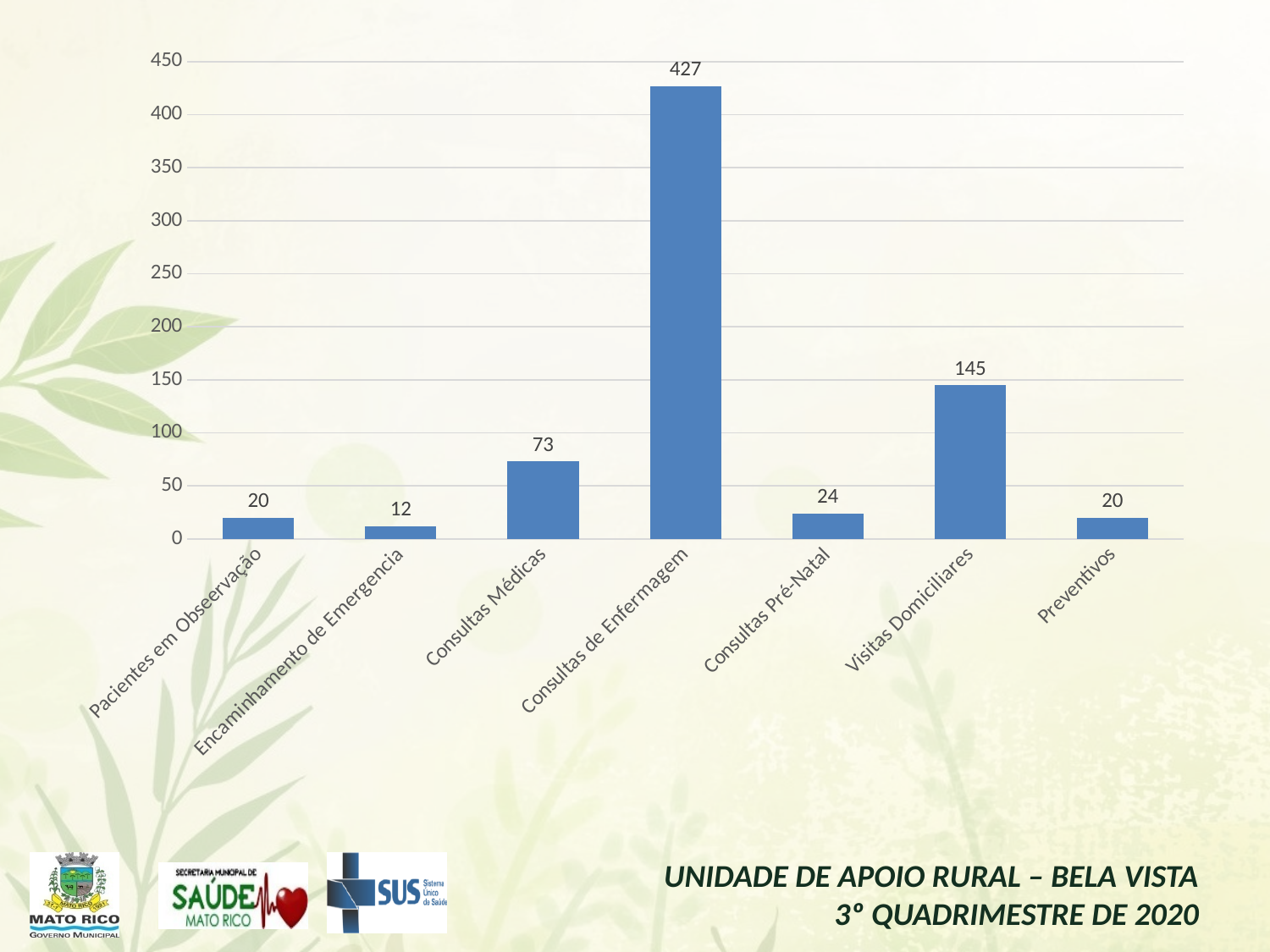
What is the value for Encaminhamento de Emergencia? 12 What is the value for Visitas Domiciliares? 145 What is the value for Consultas Médicas? 73 What is the highest value shown on the vertical axis? 450 Which is larger, Consultas Pré-Natal or Preventivos? Consultas Pré-Natal Which category has the lowest value? Encaminhamento de Emergencia How many categories are shown on the x axis? 7 What is the difference between Consultas de Enfermagem and Visitas Domiciliares? 282 What kind of chart is shown on the slide? Bar chart What is the difference between Consultas Médicas and Consultas Pré-Natal? 49 What is the value for Consultas de Enfermagem? 427 Which category has the highest value? Consultas de Enfermagem